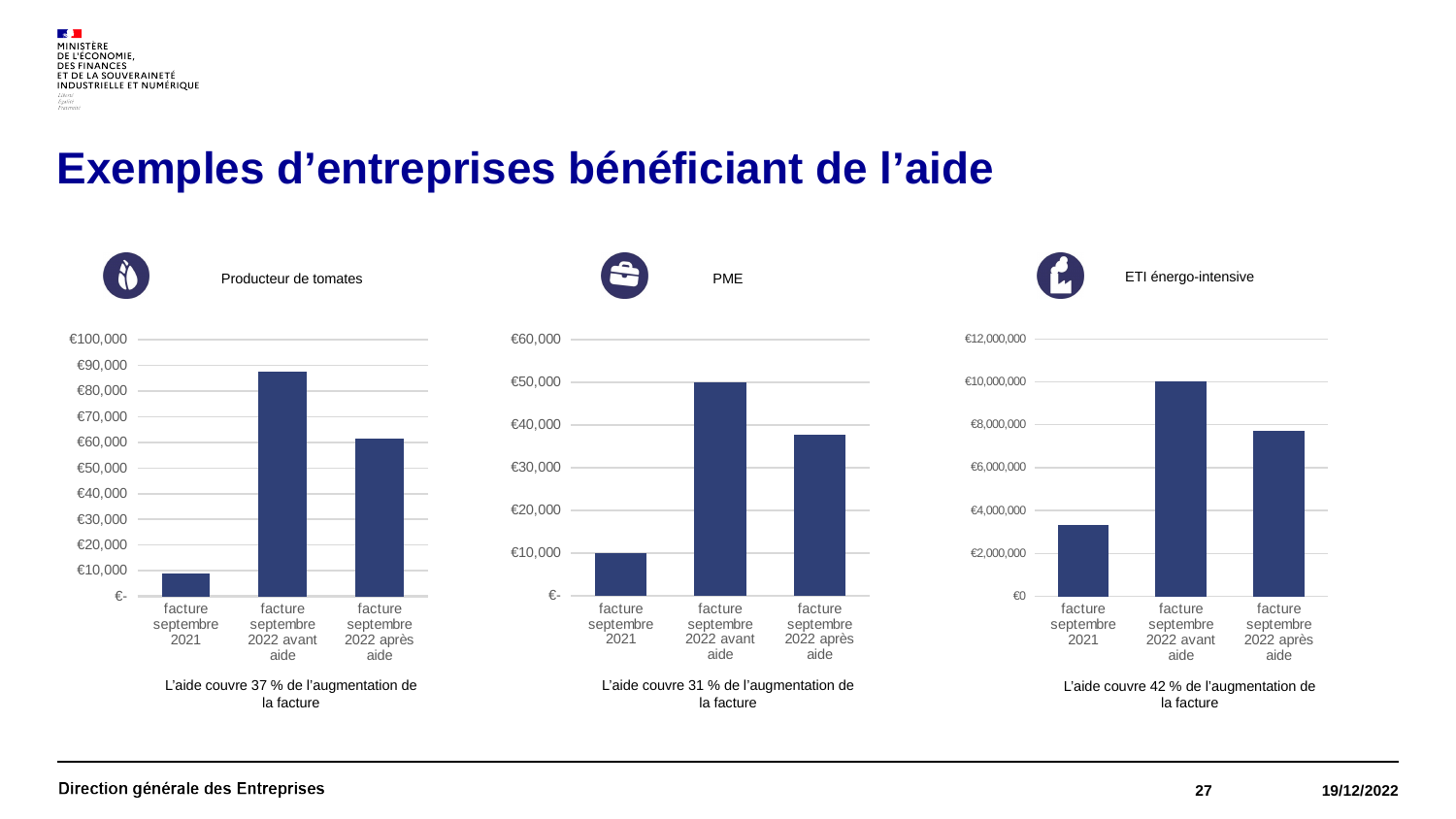
According to the text under the ETI énergo-intensive chart, what percentage of the bill increase does the aid cover? 42 % In the ETI énergo-intensive chart, what is the value for facture septembre 2022 avant aide? €10,000,000 What kind of chart is used for the Producteur de tomates example? bar chart In the PME chart, which is larger: facture septembre 2022 avant aide or facture septembre 2022 après aide? facture septembre 2022 avant aide In the PME chart, what is the value for facture septembre 2022 avant aide? €50,000 How many categories are shown in the PME chart? 3 In the ETI énergo-intensive chart, is the value for facture septembre 2022 après aide greater or less than €8,000,000? less In the PME chart, what is the value for facture septembre 2021? €10,000 In the Producteur de tomates chart, is the value for facture septembre 2022 après aide greater or less than €50,000? greater In the Producteur de tomates chart, which category has the highest value? facture septembre 2022 avant aide In the ETI énergo-intensive chart, which category has the lowest value? facture septembre 2021